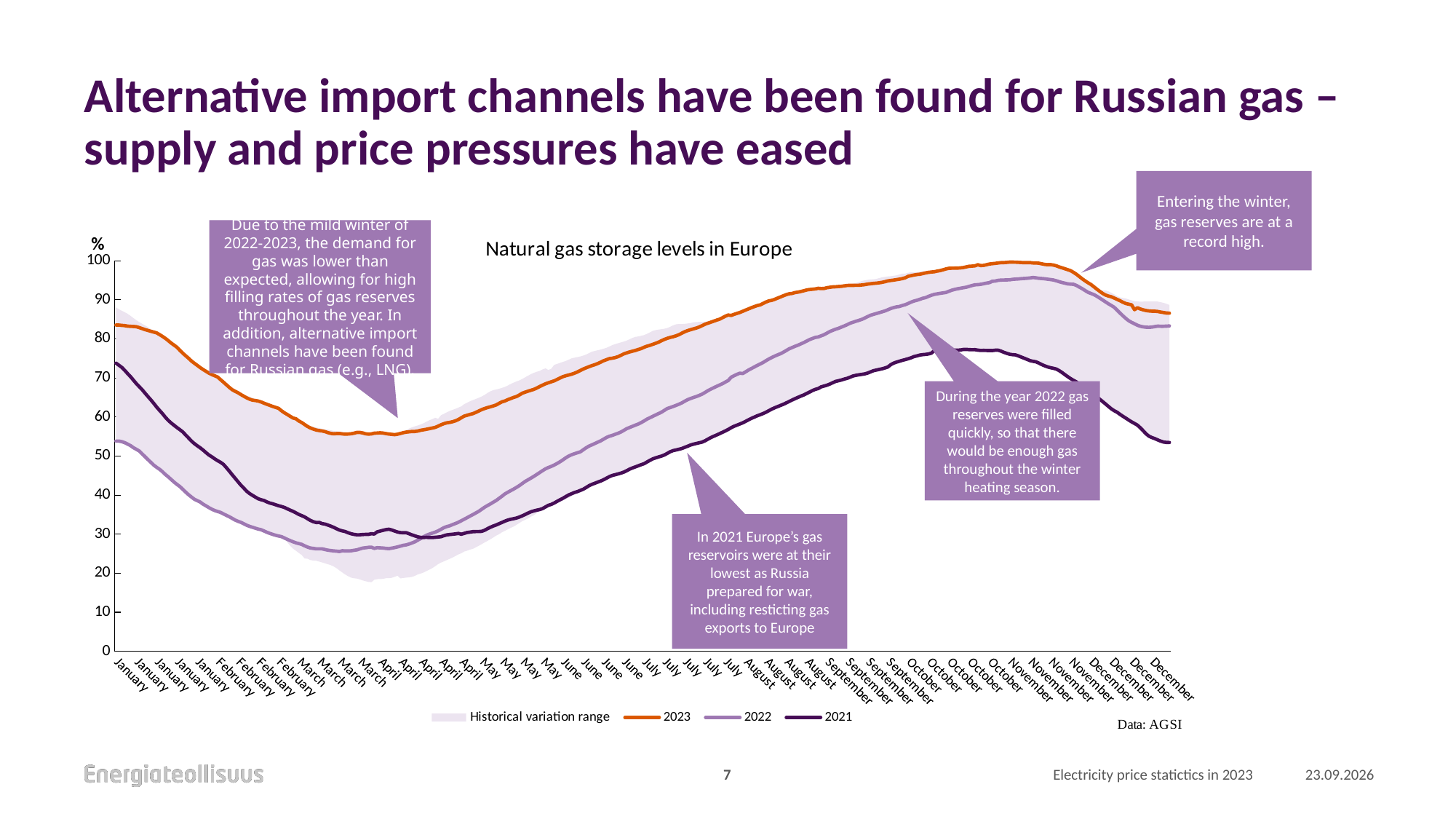
What kind of chart is shown on the slide? Line chart Is the 2023 storage level at the start of January greater or less than 80? greater Is the 2022 storage level at the start of January greater or less than 50? greater Is the lowest point of the 2023 line greater or less than 50? greater Which series is higher at the start of January, 2023 or 2021? 2023 What is the data source cited for the chart? AGSI Which series is higher at the end of December, 2022 or 2021? 2022 What is the title of the chart? Natural gas storage levels in Europe Does the 2023 line rise or fall between April and November? rise How many entries does the chart legend list? 4